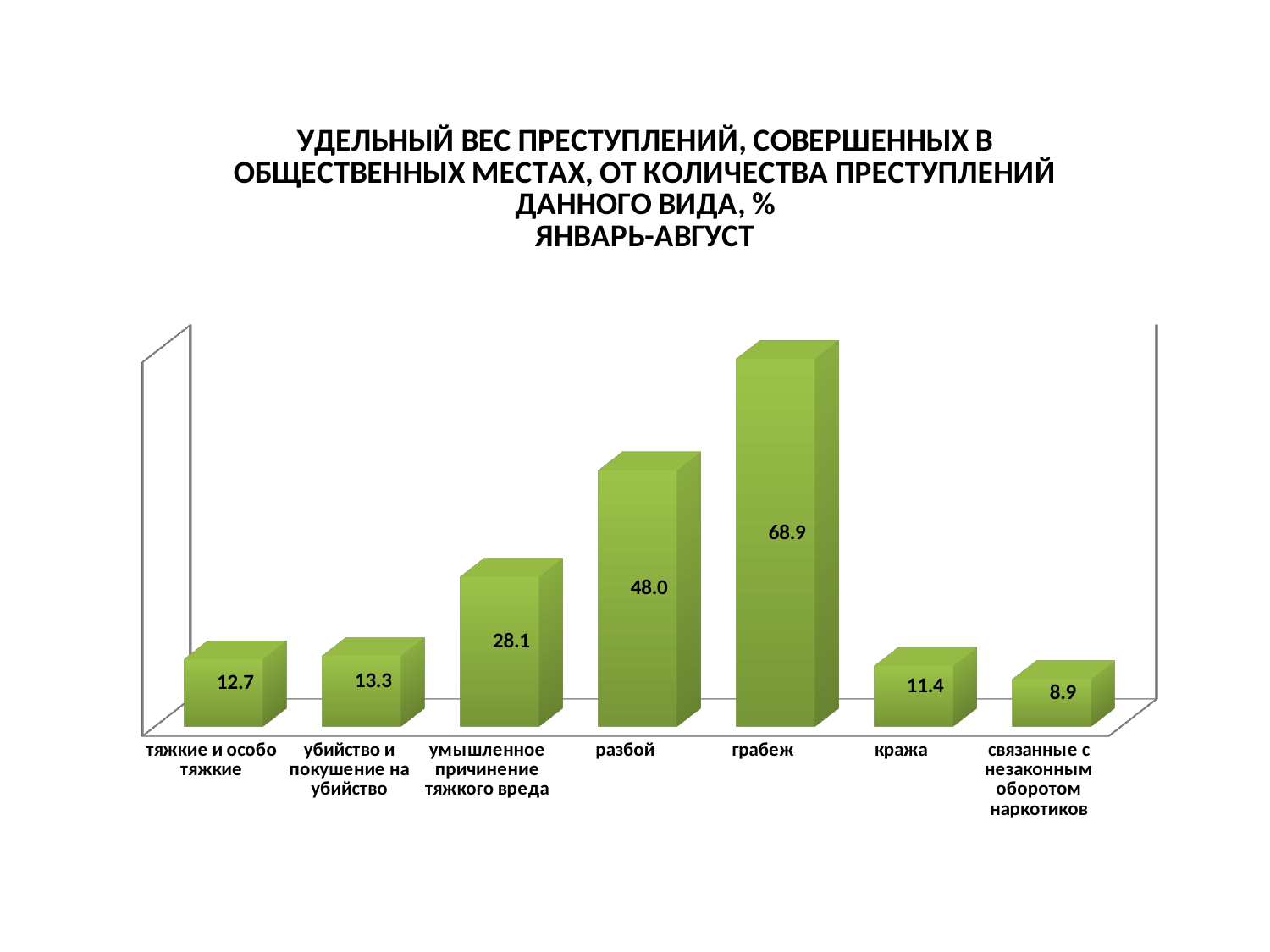
Which category has the lowest value? связанные с незаконным оборотом наркотиков What is the value for умышленное причинение тяжкого вреда? 28.1 Which category has the highest value? грабеж What is the difference between the values for убийство и покушение на убийство and тяжкие и особо тяжкие? 0.6 What is the value for грабеж? 68.9 What kind of chart is this? bar chart What period does the chart title say the data covers? январь-август Which is larger, the value for разбой or the value for умышленное причинение тяжкого вреда? разбой What is the value for кража? 11.4 How many categories are shown in the chart? 7 What is the difference between the values for грабеж and разбой? 20.9 What is the value for разбой? 48.0